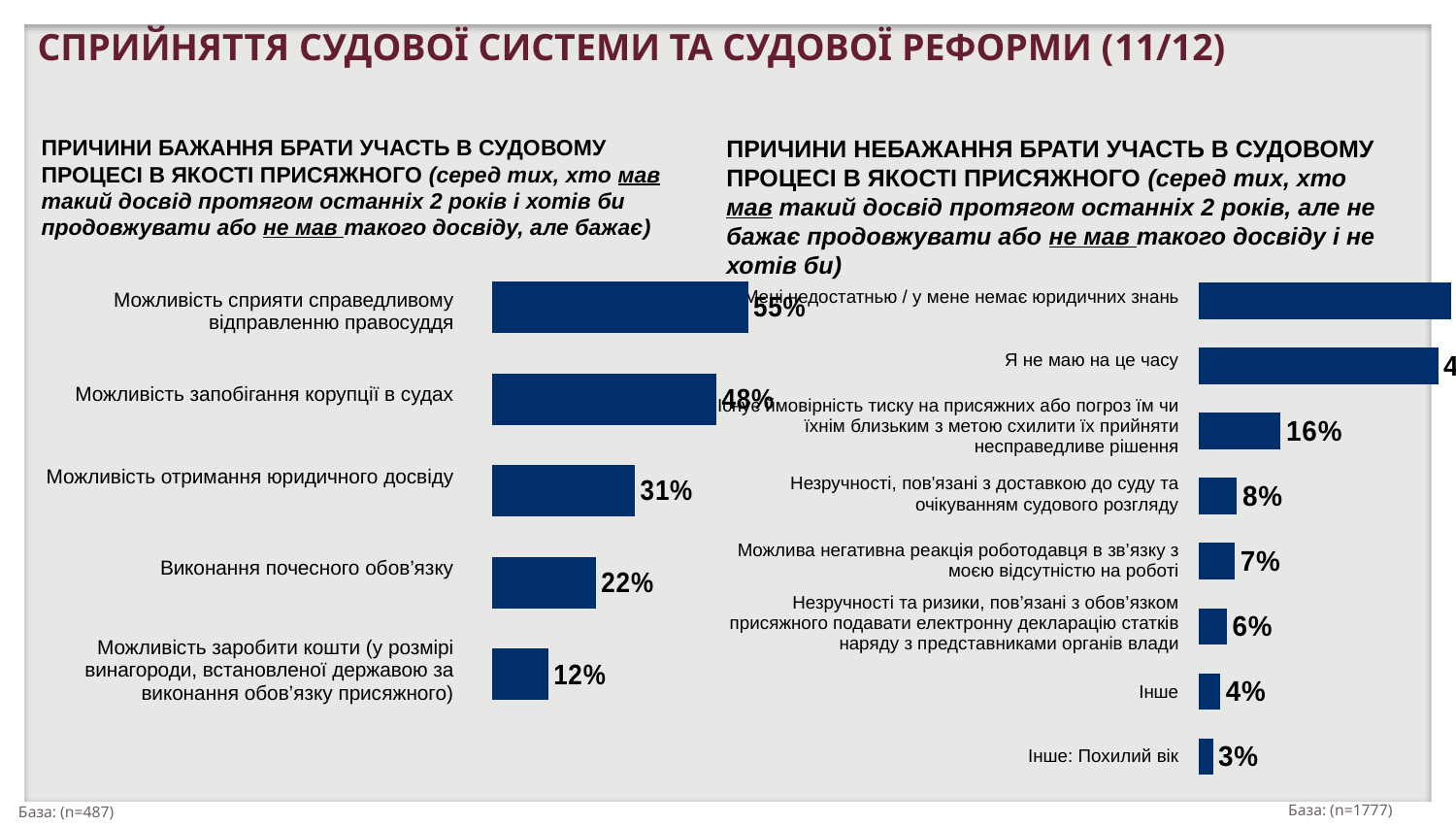
In the right chart (ПРИЧИНИ НЕБАЖАННЯ БРАТИ УЧАСТЬ...), which is larger: 'Незручності, пов'язані з доставкою до суду та очікуванням судового розгляду' or 'Інше'? Незручності, пов'язані з доставкою до суду та очікуванням судового розгляду In the right chart (ПРИЧИНИ НЕБАЖАННЯ БРАТИ УЧАСТЬ...), which category has the lowest value? Інше: Похилий вік In the left chart (ПРИЧИНИ БАЖАННЯ БРАТИ УЧАСТЬ...), which category has the lowest value? Можливість заробити кошти (у розмірі винагороди, встановленої державою за виконання обов'язку присяжного) In the right chart (ПРИЧИНИ НЕБАЖАННЯ БРАТИ УЧАСТЬ...), what is the value for 'Можлива негативна реакція роботодавця в зв'язку з моєю відсутністю на роботі'? 7% In the right chart (ПРИЧИНИ НЕБАЖАННЯ БРАТИ УЧАСТЬ...), how many categories are shown? 8 In the left chart (ПРИЧИНИ БАЖАННЯ БРАТИ УЧАСТЬ...), what is the difference between 'Можливість запобігання корупції в судах' and 'Виконання почесного обов'язку'? 26% In the left chart (ПРИЧИНИ БАЖАННЯ БРАТИ УЧАСТЬ...), how many categories are shown? 5 In the left chart (ПРИЧИНИ БАЖАННЯ БРАТИ УЧАСТЬ...), what is the value for 'Можливість отримання юридичного досвіду'? 31% In the left chart (ПРИЧИНИ БАЖАННЯ БРАТИ УЧАСТЬ...), which category has the highest value? Можливість сприяти справедливому відправленню правосуддя What type of chart is the left chart (ПРИЧИНИ БАЖАННЯ БРАТИ УЧАСТЬ...)? Bar chart In the left chart (ПРИЧИНИ БАЖАННЯ БРАТИ УЧАСТЬ...), what is the value for 'Можливість сприяти справедливому відправленню правосуддя'? 55% In the right chart (ПРИЧИНИ НЕБАЖАННЯ БРАТИ УЧАСТЬ...), what is the value for 'Існує ймовірність тиску на присяжних або погроз їм чи їхнім близьким з метою схилити їх прийняти несправедливе рішення'? 16%